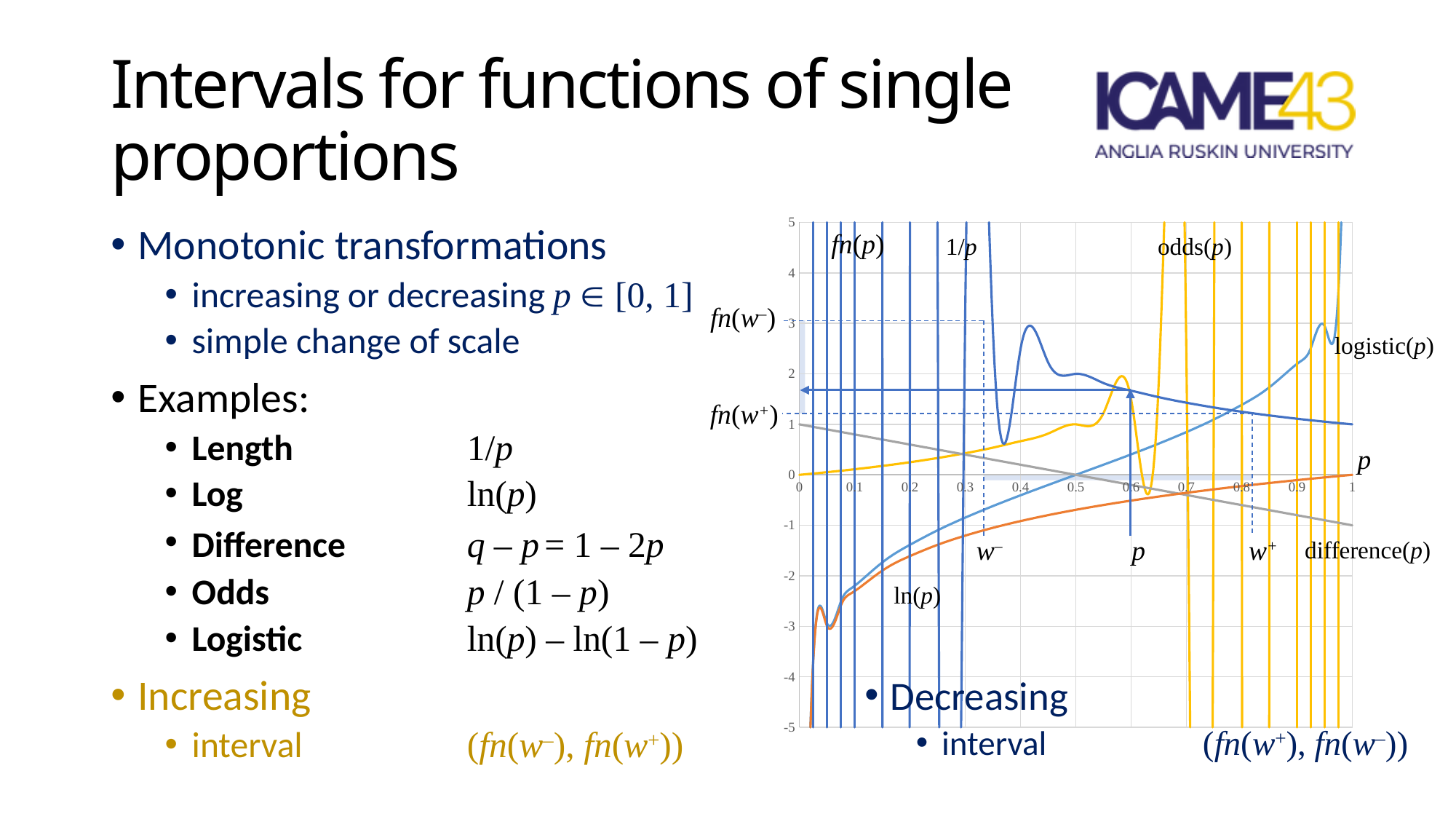
What is the value of ln(p) at p = 1? 0 What is the value of difference(p) at p = 0.5? 0 What is the lowest value shown on the chart's vertical axis? -5 What is the value of difference(p) at p = 0? 1 How many labelled function curves are plotted on the chart? 5 What kind of chart is shown on the slide? line chart Does the difference(p) curve rise or fall as p increases from 0 to 1? fall Is the value of ln(p) at p = 0.1 greater or less than -1? less Does the logistic(p) curve rise or fall as p increases from 0 to 1? rise What is the highest value shown on the chart's vertical axis? 5 At p = 0.9, which is larger: logistic(p) or difference(p)? logistic(p) Does the ln(p) curve rise or fall as p increases from 0 to 1? rise